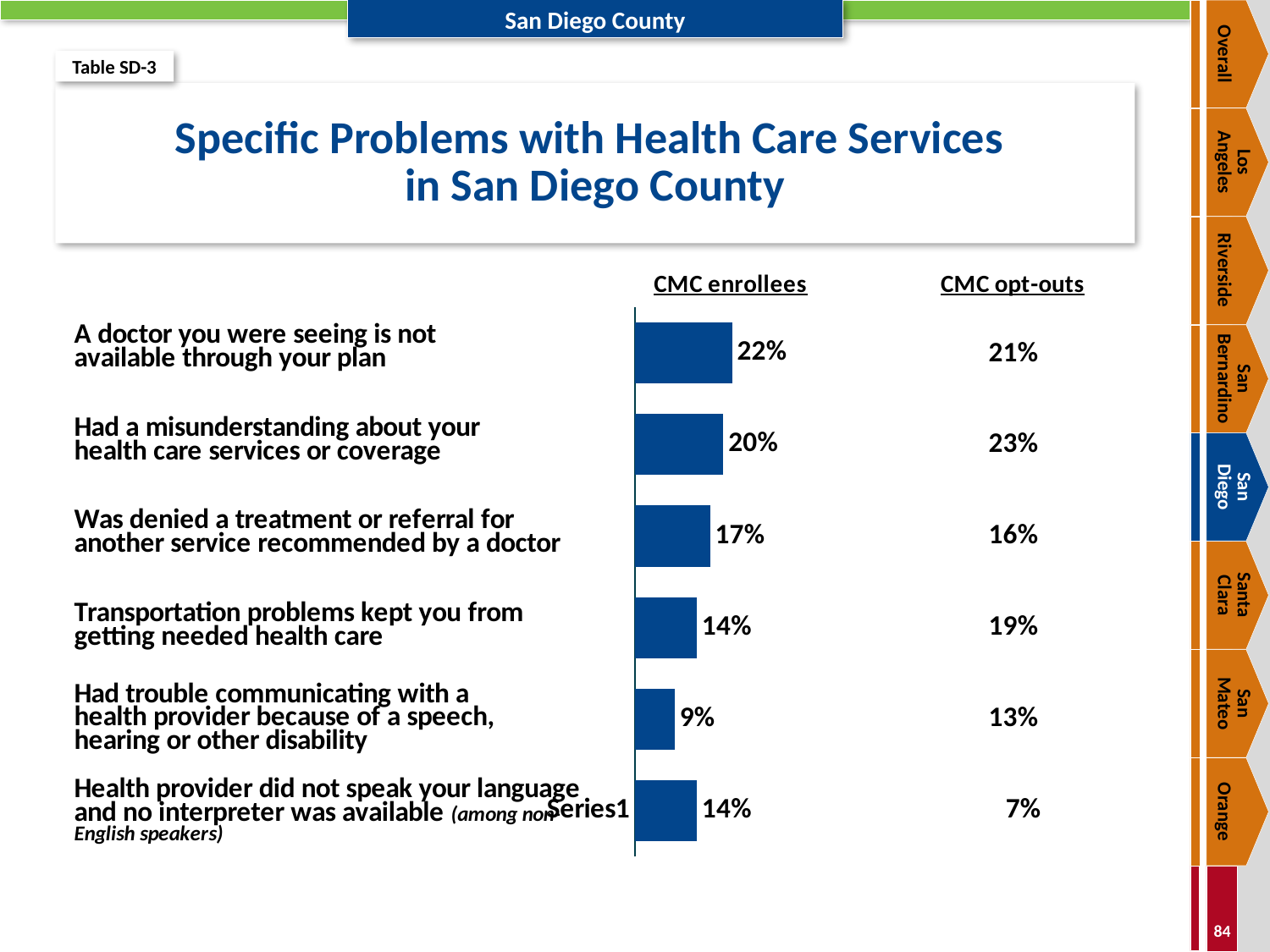
Which problem has the highest CMC enrollees value in the bar chart? A doctor you were seeing is not available through your plan What is the CMC enrollees value for 'Transportation problems kept you from getting needed health care'? 14% What is the title of the chart on the slide? Specific Problems with Health Care Services in San Diego County What is the CMC opt-outs value shown for 'Health provider did not speak your language and no interpreter was available'? 7% What kind of chart is shown on the slide? bar chart How many problem categories are plotted in the bar chart? 6 What is the difference between the highest and lowest CMC enrollees values in the bar chart? 13 percentage points What is the CMC enrollees value for 'Had trouble communicating with a health provider because of a speech, hearing or other disability'? 9% Which problem has the lowest CMC enrollees value in the bar chart? Had trouble communicating with a health provider because of a speech, hearing or other disability What is the CMC enrollees value for 'A doctor you were seeing is not available through your plan'? 22% For CMC enrollees, which is larger: 'Had a misunderstanding about your health care services or coverage' or 'Was denied a treatment or referral for another service recommended by a doctor'? Had a misunderstanding about your health care services or coverage What is the CMC enrollees value for 'Had a misunderstanding about your health care services or coverage'? 20%